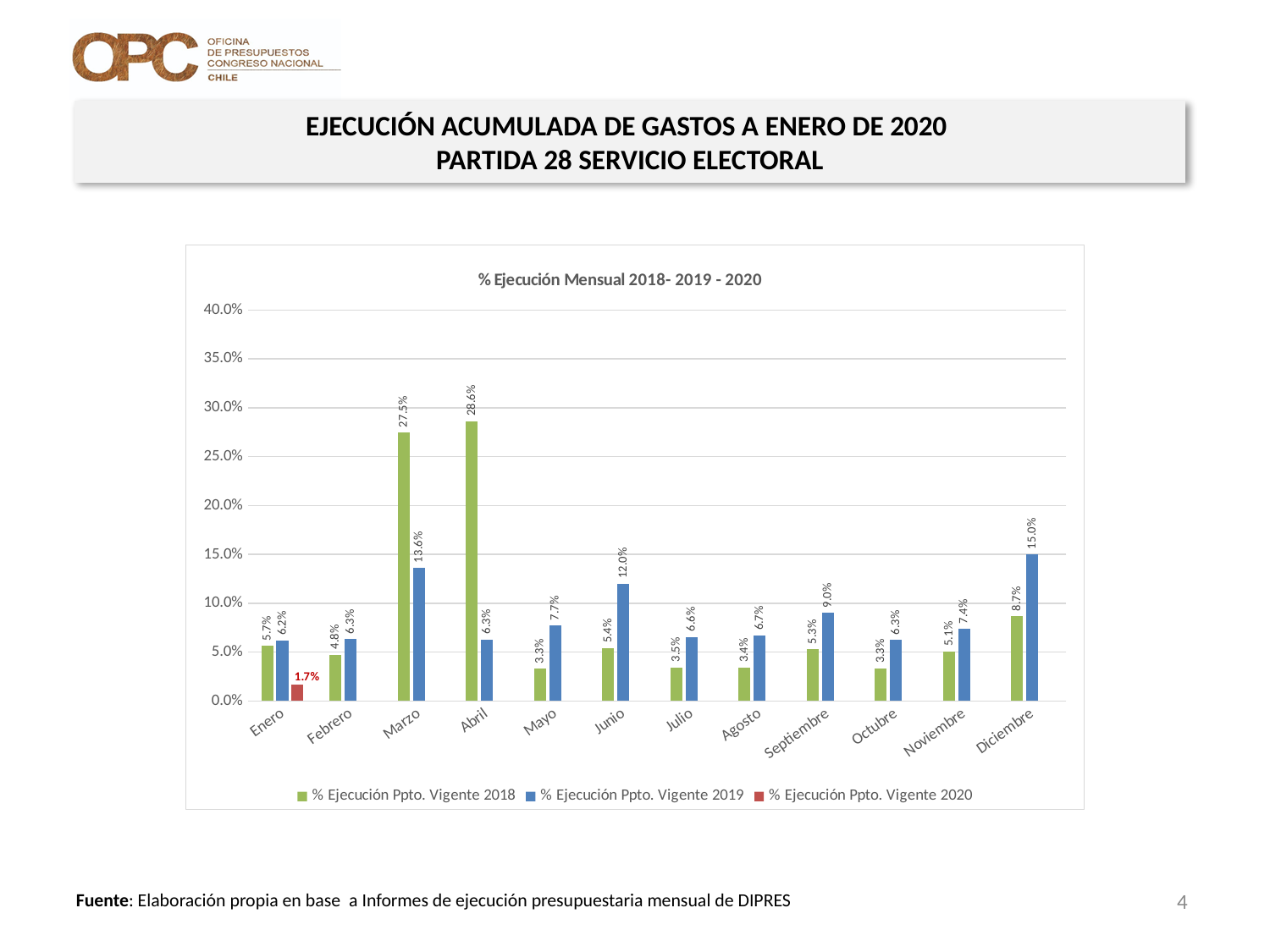
How many series does the legend list? 3 Which month has the lowest value for % Ejecución Ppto. Vigente 2019? Enero How many months are shown on the x axis? 12 What kind of chart is shown on the slide? Bar chart Is the value for % Ejecución Ppto. Vigente 2018 in Marzo greater or less than 25.0%? greater What is the value for % Ejecución Ppto. Vigente 2020 in Enero? 1.7% What is the value for % Ejecución Ppto. Vigente 2019 in Diciembre? 15.0% What is the value for % Ejecución Ppto. Vigente 2018 in Abril? 28.6% What is the difference between the 2018 and 2019 values in Marzo? 13.9% Which month has the highest value for % Ejecución Ppto. Vigente 2019? Diciembre Which is larger in Junio: the 2018 value or the 2019 value? 2019 Which month has the highest value for % Ejecución Ppto. Vigente 2018? Abril